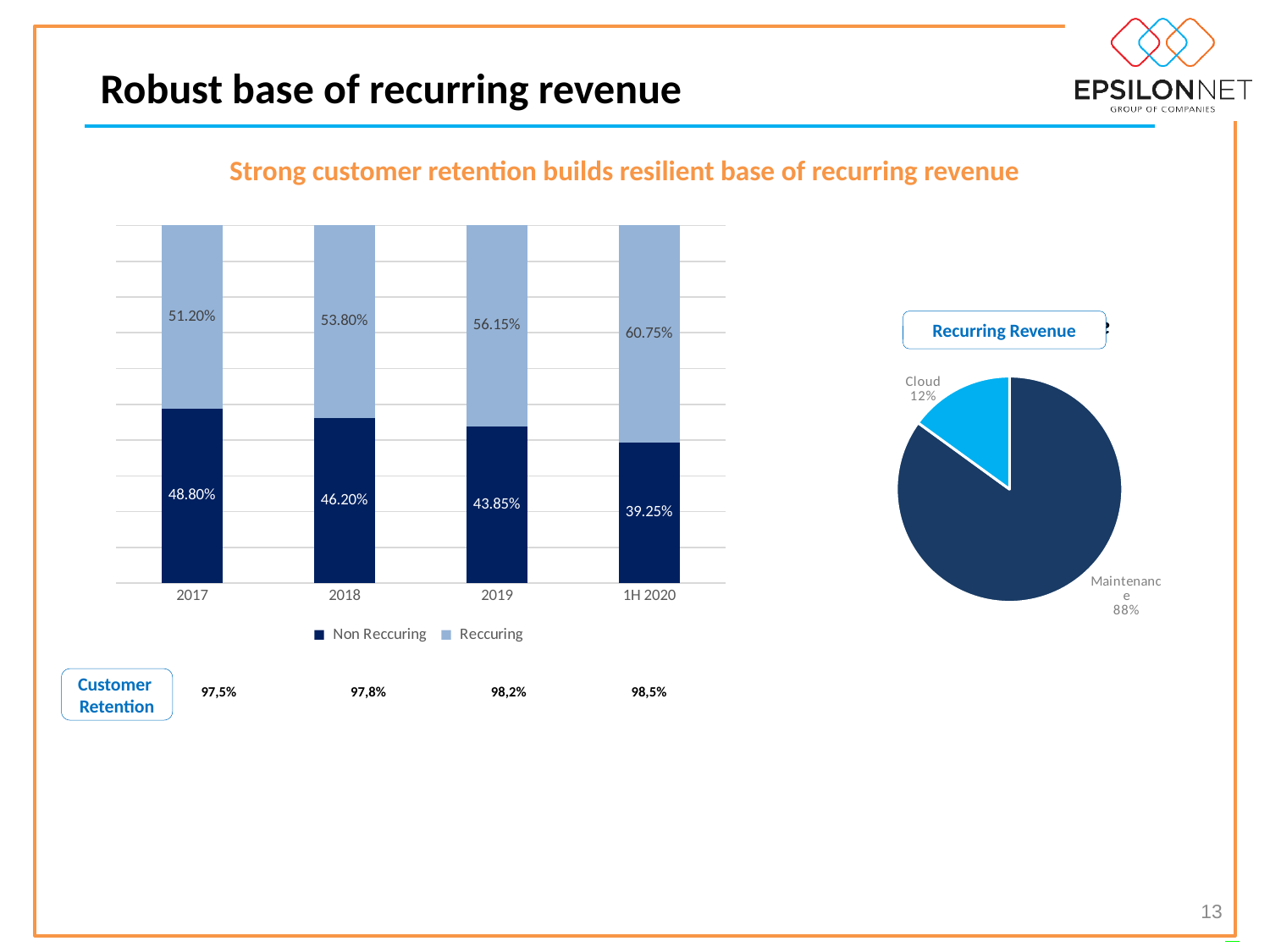
In the stacked bar chart on the left, what is the difference between the Reccuring and Non Reccuring values for 2018? 7.60% In the stacked bar chart on the left, which category has the highest Reccuring value? 1H 2020 In the Recurring Revenue pie chart, what share does Cloud have? 12% In the stacked bar chart on the left, is the Non Reccuring value larger for 2017 or for 2019? 2017 In the stacked bar chart on the left, does the Reccuring value rise or fall from 2017 to 1H 2020? rise In the stacked bar chart on the left, how many series does the legend list? 2 What kind of chart is the chart on the left of the slide? stacked bar chart In the stacked bar chart on the left, what is the Non Reccuring value for 1H 2020? 39.25% In the stacked bar chart on the left, how many categories are shown on the x axis? 4 In the stacked bar chart on the left, what is the Reccuring value for 2019? 56.15% In the Recurring Revenue pie chart, which slice is the largest? Maintenance In the stacked bar chart on the left, which category has the lowest Non Reccuring value? 1H 2020